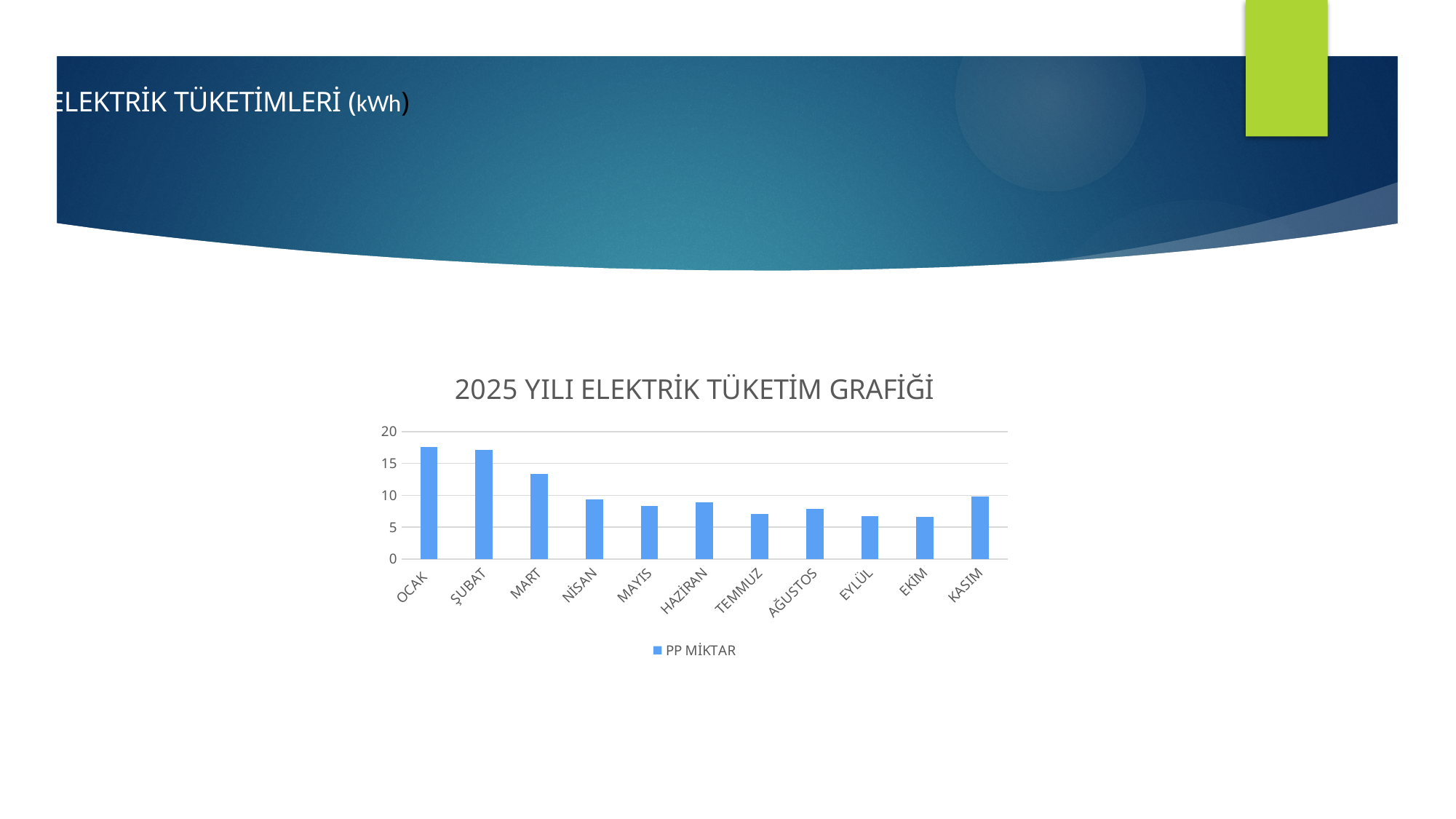
Is the value for EKİM greater or less than 5? greater How many series does the chart's legend list? 1 What is the title of the chart? 2025 YILI ELEKTRİK TÜKETİM GRAFİĞİ Is the value for OCAK greater or less than 15? greater Is the value for MART greater or less than 15? less What kind of chart is shown on the slide? bar chart Which is larger, the value for MART or the value for NİSAN? MART How many months (categories) are plotted on the x axis of the chart? 11 What is the name of the series shown in the chart's legend? PP MİKTAR Do the values rise or fall from OCAK to MART? fall